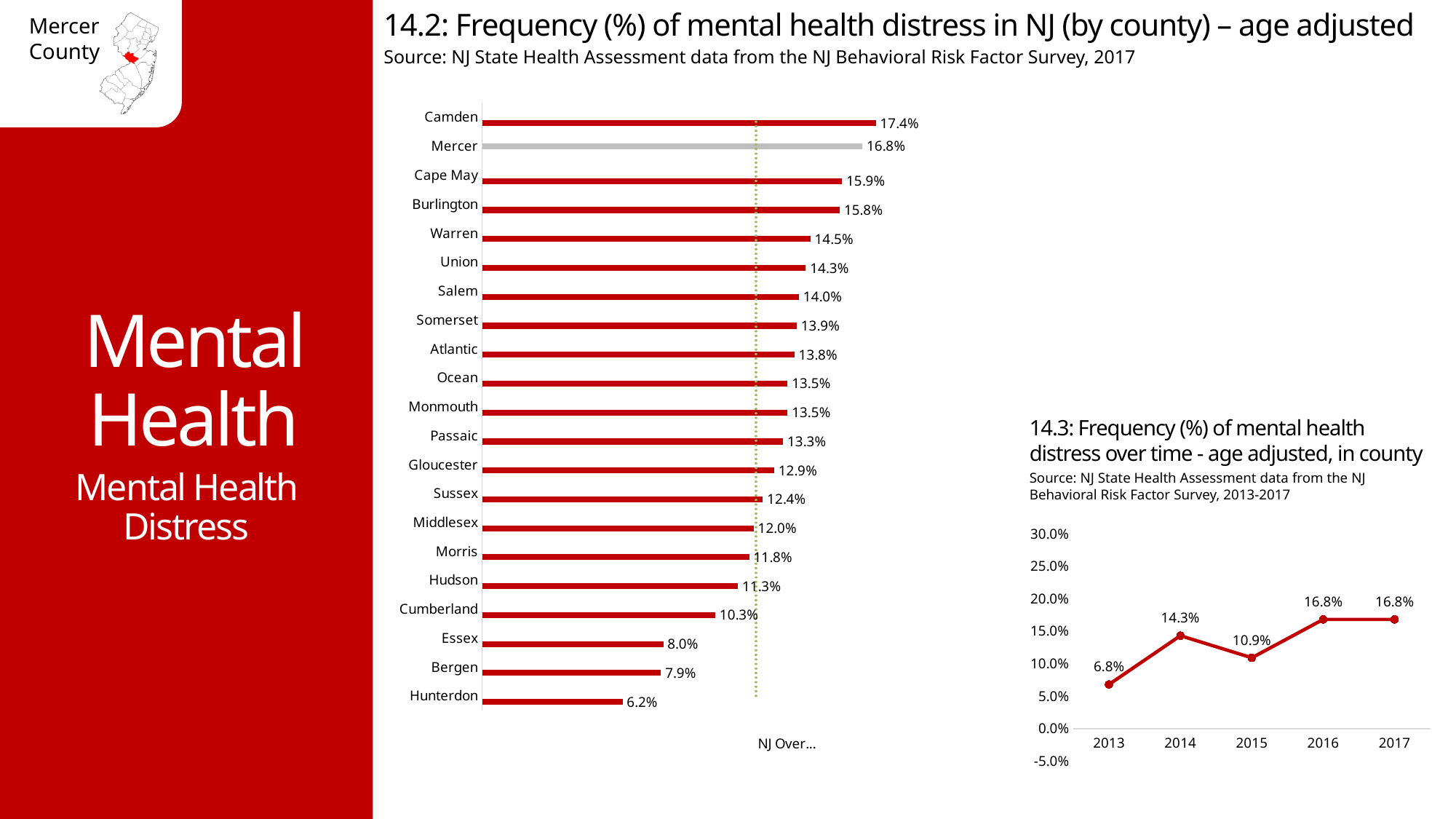
In the chart '14.2: Frequency (%) of mental health distress in NJ (by county) – age adjusted', how many counties are shown? 21 In the chart '14.2: Frequency (%) of mental health distress in NJ (by county) – age adjusted', which county has the lowest value? Hunterdon In the chart '14.2: Frequency (%) of mental health distress in NJ (by county) – age adjusted', which county has the highest value? Camden In the chart '14.3: Frequency (%) of mental health distress over time - age adjusted, in county', which year has the lowest value? 2013 In the chart '14.3: Frequency (%) of mental health distress over time - age adjusted, in county', what is the difference between 2014 and 2013? 7.5% What kind of chart is '14.3: Frequency (%) of mental health distress over time - age adjusted, in county'? Line chart In the chart '14.2: Frequency (%) of mental health distress in NJ (by county) – age adjusted', what is the value for Mercer? 16.8% In the chart '14.2: Frequency (%) of mental health distress in NJ (by county) – age adjusted', which is larger, Essex or Cumberland? Cumberland In the chart '14.3: Frequency (%) of mental health distress over time - age adjusted, in county', what is the value for 2015? 10.9% What kind of chart is '14.2: Frequency (%) of mental health distress in NJ (by county) – age adjusted'? Bar chart In the chart '14.2: Frequency (%) of mental health distress in NJ (by county) – age adjusted', what is the difference between Camden and Hunterdon? 11.2% In the chart '14.2: Frequency (%) of mental health distress in NJ (by county) – age adjusted', what is the value for Gloucester? 12.9%